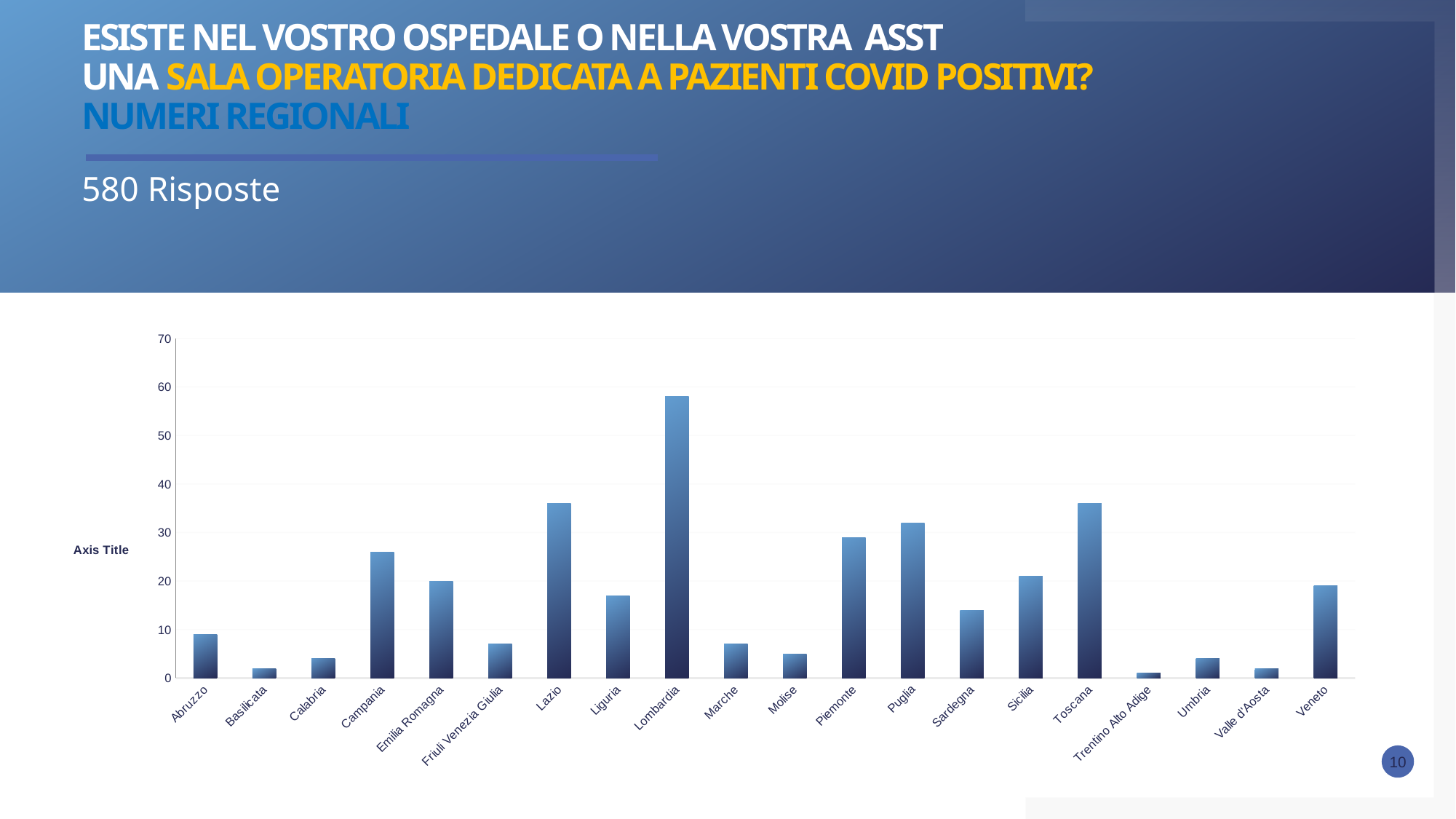
Is the value for Liguria greater or less than 20? less What is the highest value shown on the vertical axis of the chart? 70 Which has the larger value, Veneto or Sardegna? Veneto What kind of chart is shown on the slide? bar chart Is the value for Molise greater or less than 10? less Which region has the highest bar in the chart? Lombardia Which has the larger value, Puglia or Piemonte? Puglia Is the value for Lombardia greater or less than 50? greater How many regions are shown on the x axis of the chart? 20 Which has the larger value, Sicilia or Liguria? Sicilia